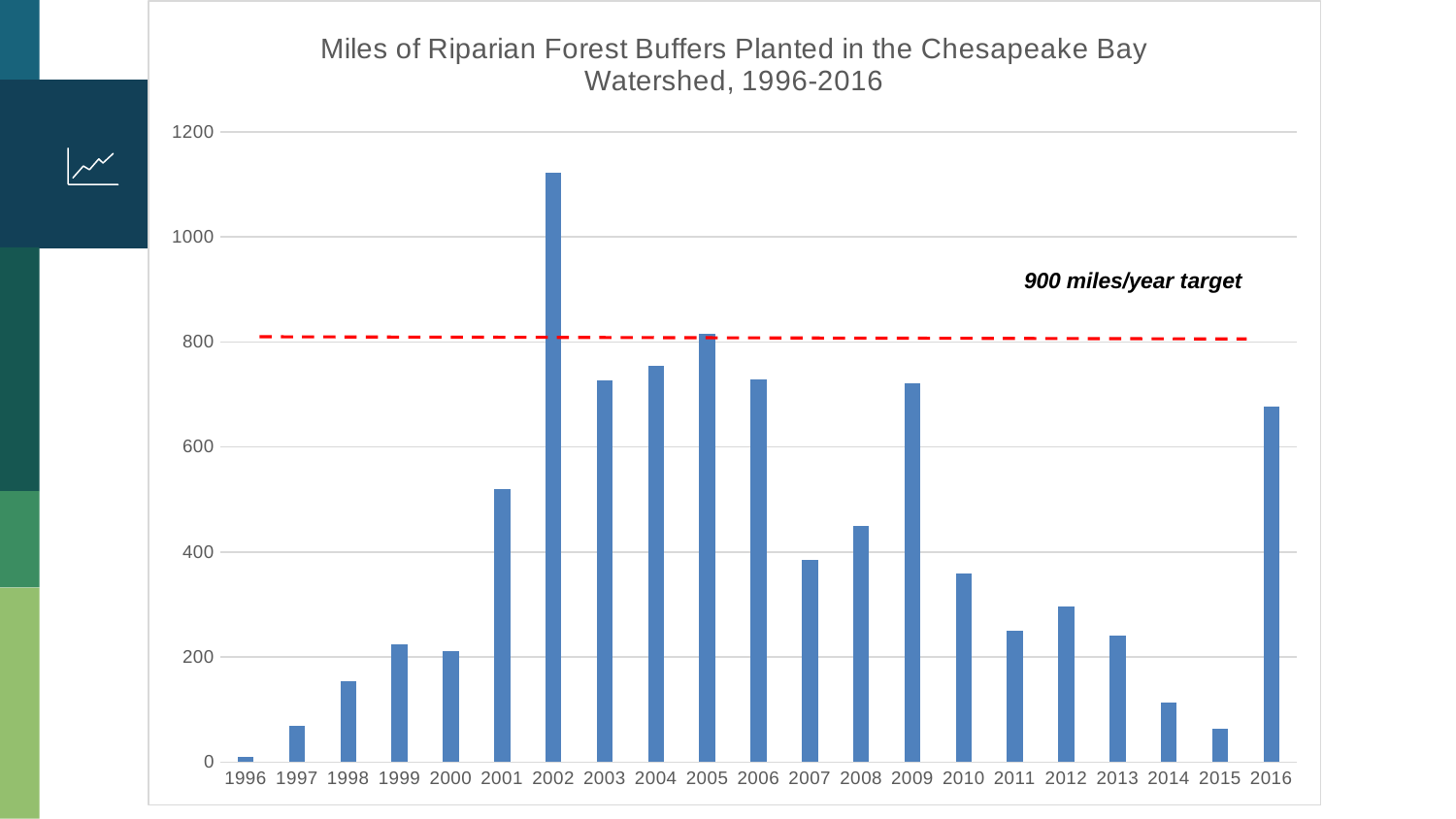
What kind of chart is shown on the slide? bar chart Do the values generally rise or fall from 2009 to 2015? fall What does the red dashed line on the chart represent, according to its label? 900 miles/year target Is the value for 2014 greater or less than 200? less Which year has the larger value, 2001 or 2008? 2001 Is the value for 2007 greater or less than 400? less What is the title of the chart? Miles of Riparian Forest Buffers Planted in the Chesapeake Bay Watershed, 1996-2016 Is the value for 2002 greater or less than 1000? greater Which year has the lowest bar? 1996 Which year has the highest bar? 2002 How many years are shown on the x axis of the chart? 21